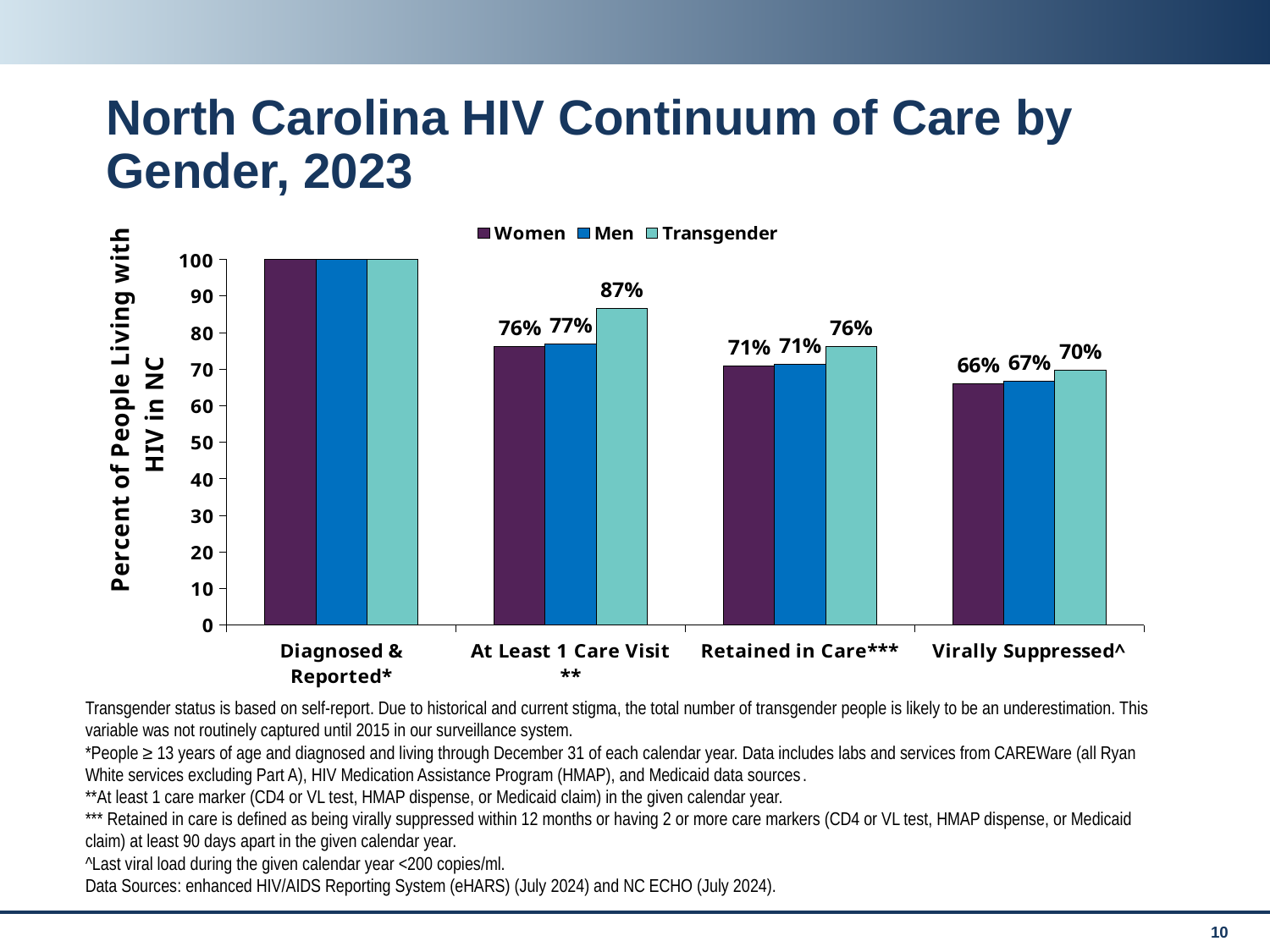
Which gender group has the highest value for At Least 1 Care Visit**? Transgender What is the difference between the Transgender and Men values for Retained in Care***? 5% Which gender group has the lowest value for Virally Suppressed^? Women What kind of chart is shown on the slide? Bar chart What is the value for Men in the Virally Suppressed^ category? 67% Is the value for Transgender in Virally Suppressed^ larger or smaller than the value for Men in Virally Suppressed^? larger What percentage of transgender people living with HIV in NC had at least 1 care visit? 87% How many categories are shown on the x axis of the chart? 4 What is the difference between the Transgender and Women values for At Least 1 Care Visit**? 11% Is the value for Women in the Diagnosed & Reported* category greater or less than 90? greater What is the value for Women in the Retained in Care*** category? 71% How many series does the chart legend list? 3